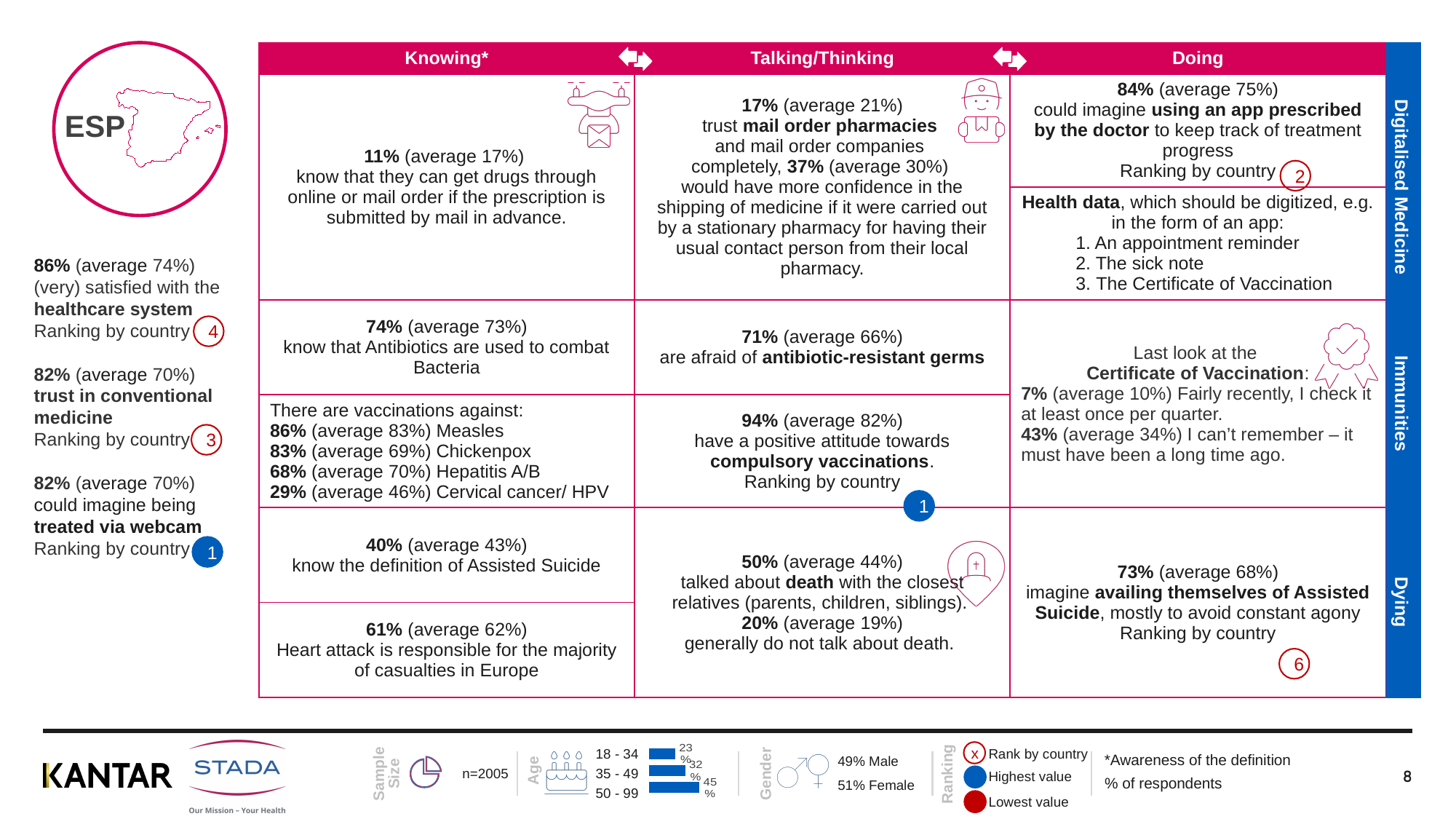
In the age bar chart at the bottom of the slide, what is the value for the 35 - 49 group? 32% In the age bar chart at the bottom of the slide, which age group has the highest value? 50 - 99 In the age bar chart at the bottom of the slide, which is larger: the 35 - 49 group or the 18 - 34 group? 35 - 49 What kind of chart is used to show the age distribution at the bottom of the slide? Bar chart How many age groups are shown in the age bar chart at the bottom of the slide? 3 In the age bar chart at the bottom of the slide, what is the difference between the 50 - 99 group and the 18 - 34 group? 22 percentage points In the age bar chart at the bottom of the slide, what is the value for the 18 - 34 group? 23% In the age bar chart at the bottom of the slide, do the values rise or fall from the youngest group to the oldest group? Rise What does the small bar chart at the bottom of the slide show? The age distribution of the sample In the age bar chart at the bottom of the slide, what is the value for the 50 - 99 group? 45% In the age bar chart at the bottom of the slide, which age group has the lowest value? 18 - 34 In the age bar chart at the bottom of the slide, what do the three values add up to? 100%